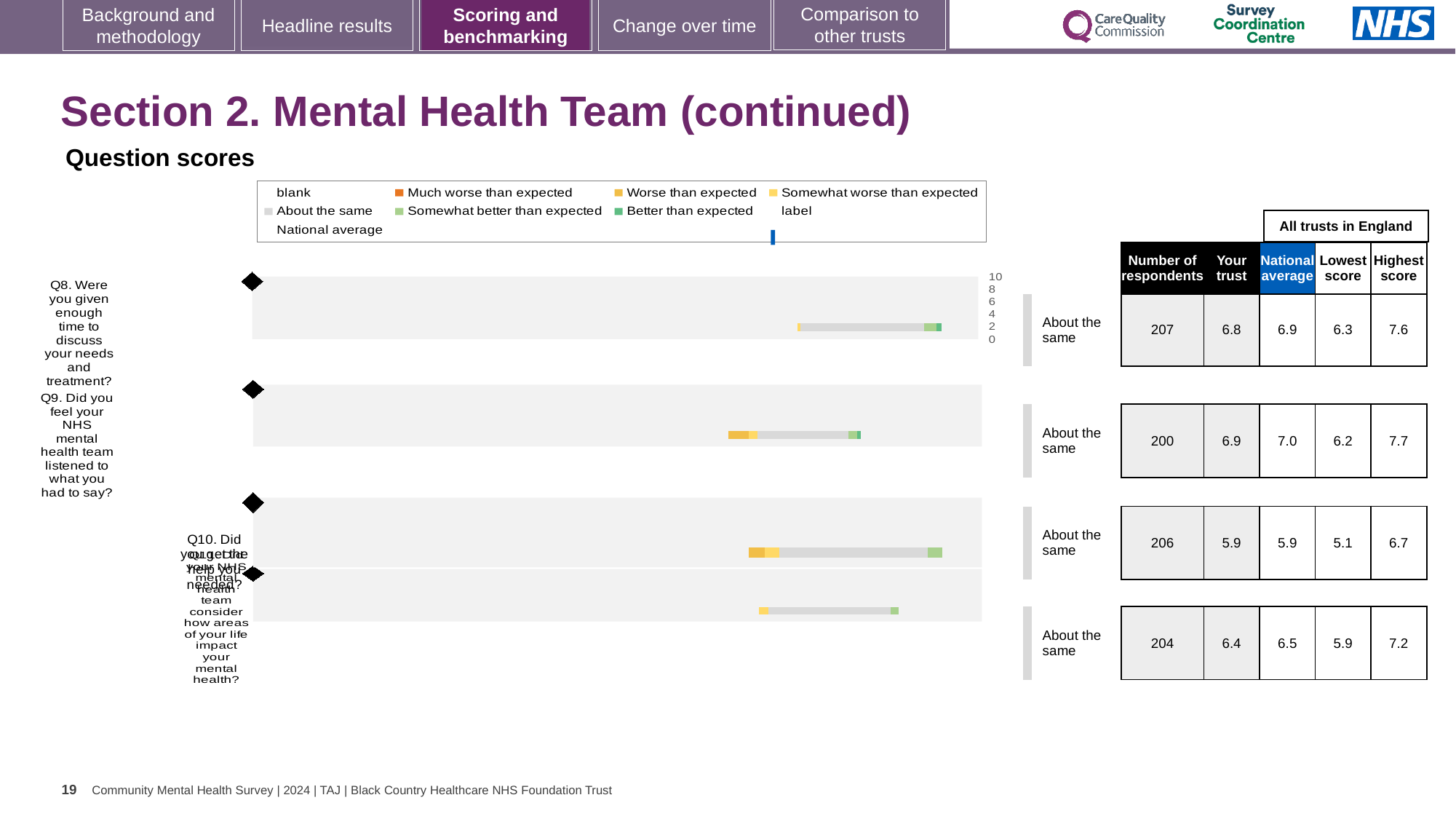
In the table beside the question scores chart, what is the 'Your trust' score for Q9? 6.9 What is the title of the chart on this slide? Question scores In the table beside the question scores chart, how many respondents answered Q11? 204 According to the table beside the question scores chart, which question has the highest number of respondents? Q8 According to the table beside the question scores chart, which question has the lowest 'Your trust' score? Q10 In the question scores chart, what colour does the legend assign to 'Much worse than expected'? orange In the table beside the question scores chart, what is the difference between the highest score and the lowest score for Q8? 1.3 What kind of chart is used to show the question scores on this slide? bar chart In the table beside the question scores chart, what is the national average for Q10? 5.9 What benchmark label is shown next to the bar for Q8 in the question scores chart? About the same In the table beside the question scores chart, is the 'Your trust' score for Q9 higher or lower than the 'Your trust' score for Q11? higher How many questions (bars) are plotted in the question scores chart? 4